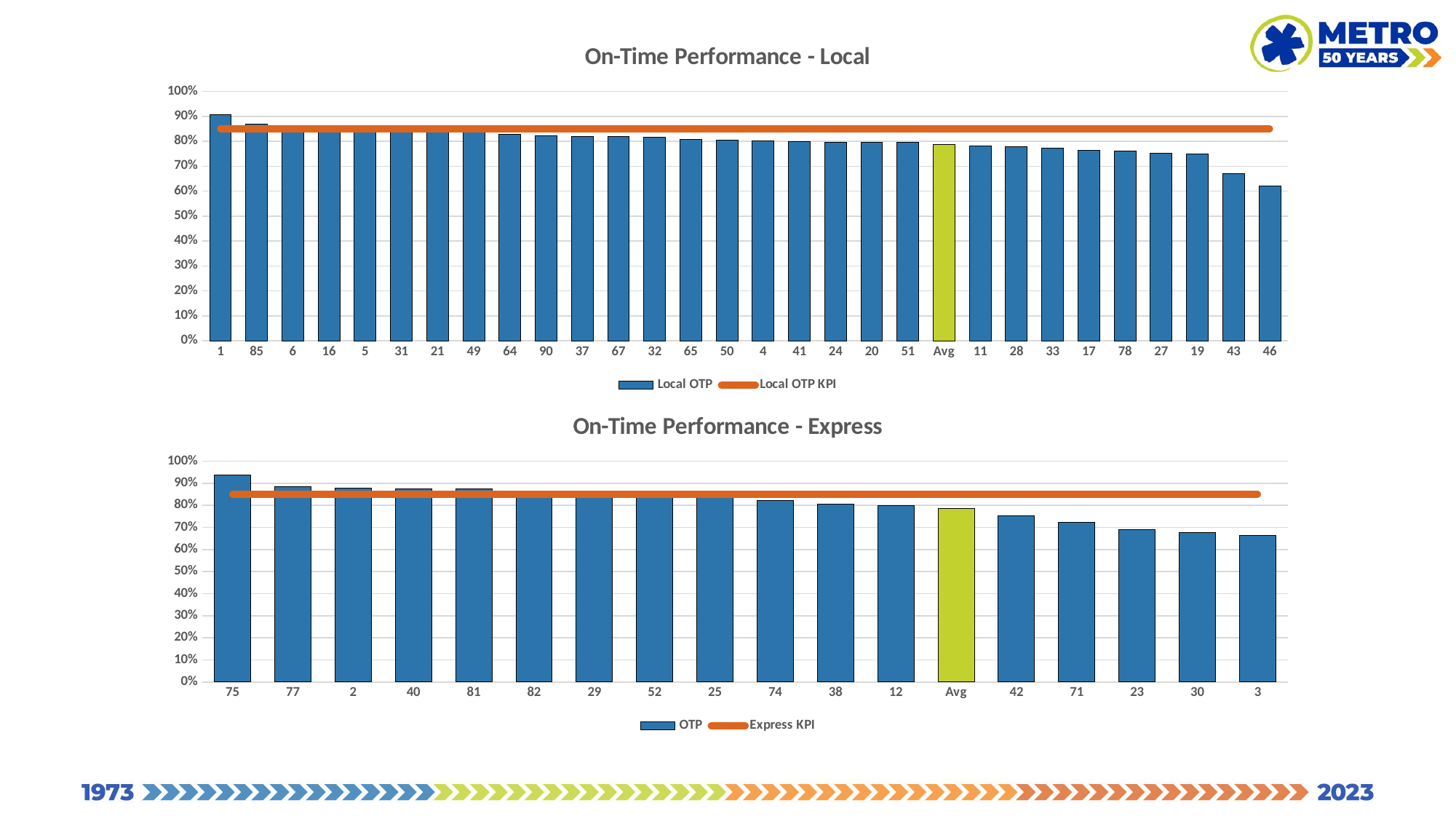
In the "On-Time Performance - Express" chart, do the bar values rise or fall from left to right along the x axis? fall In the "On-Time Performance - Local" chart, which route has the lowest on-time performance? 46 In the "On-Time Performance - Express" chart, is the value for route 75 greater or less than 90%? greater In the "On-Time Performance - Local" chart, is the value for route 1 greater or less than 80%? greater In the "On-Time Performance - Express" chart, which route has the lowest on-time performance? 3 In the "On-Time Performance - Express" chart, which route has the highest on-time performance? 75 In the "On-Time Performance - Local" chart, how many categories are shown on the x axis? 30 In the "On-Time Performance - Local" chart, which route has the highest on-time performance? 1 In the "On-Time Performance - Local" chart, how many entries does the legend list? 2 In the "On-Time Performance - Local" chart, is the value for route 46 greater or less than 70%? less What type of chart is the "On-Time Performance - Local" chart? bar chart In the "On-Time Performance - Express" chart, how many categories are shown on the x axis? 18